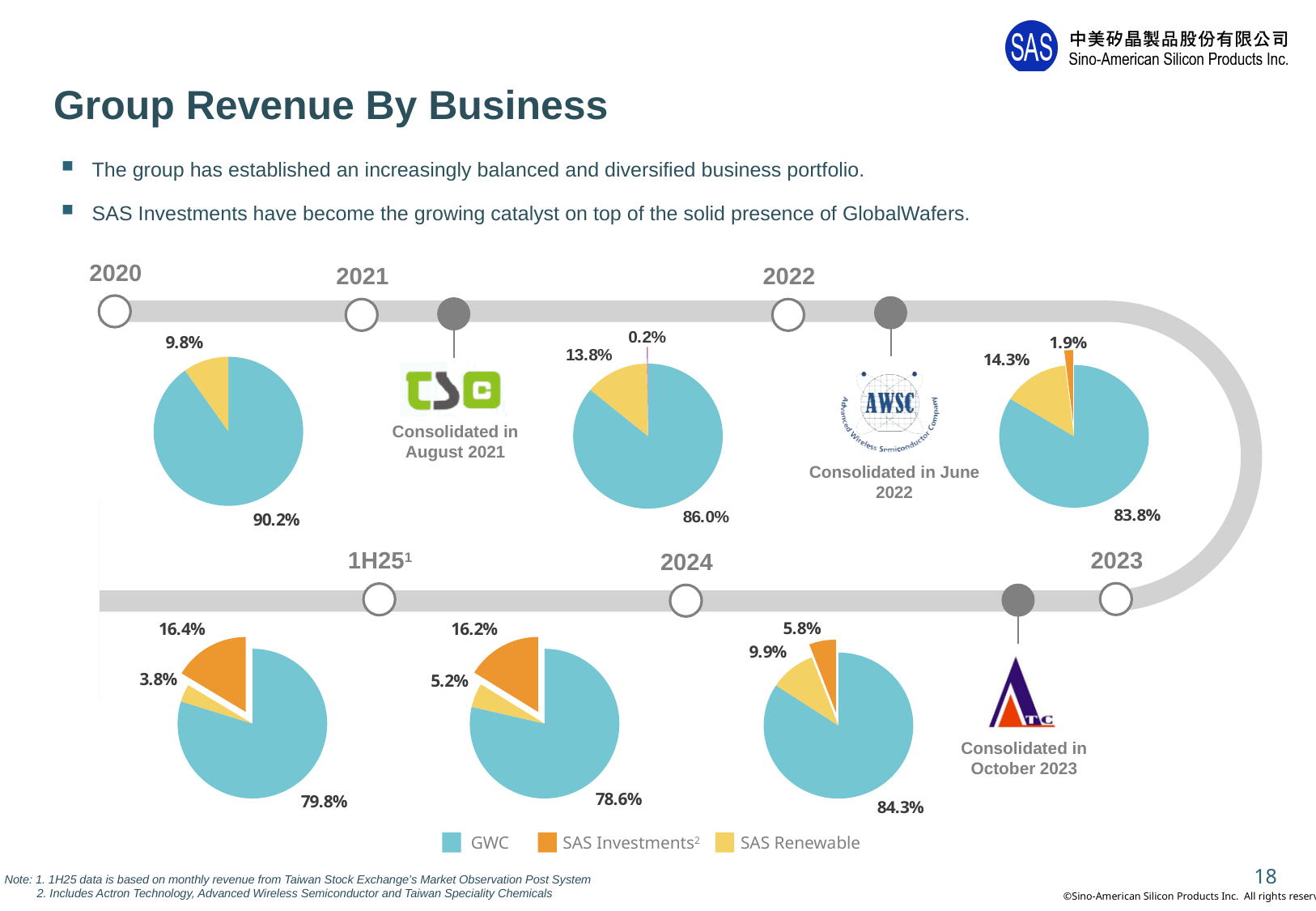
How many series does the legend list for the pie charts? 3 In the 2022 pie chart, what share of group revenue does SAS Renewable account for? 14.3% In the 2020 pie chart, what share of group revenue does GWC account for? 90.2% In the 1H25 pie chart, which business has the largest share of revenue? GWC What is the difference between the SAS Investments share in 1H25 and in 2024? 0.2% In the 2023 pie chart, which is larger: the SAS Renewable share or the SAS Investments share? SAS Renewable In the 2024 pie chart, what share of group revenue does GWC account for? 78.6% In the 1H25 pie chart, what share of group revenue does SAS Renewable account for? 3.8% In the 2023 pie chart, what share of group revenue does SAS Investments account for? 5.8% What kind of chart is used to show the revenue breakdown for each year? Pie chart In the 2024 pie chart, which business has the smallest share of revenue? SAS Renewable In the 2021 pie chart, what share of group revenue does SAS Investments account for? 0.2%